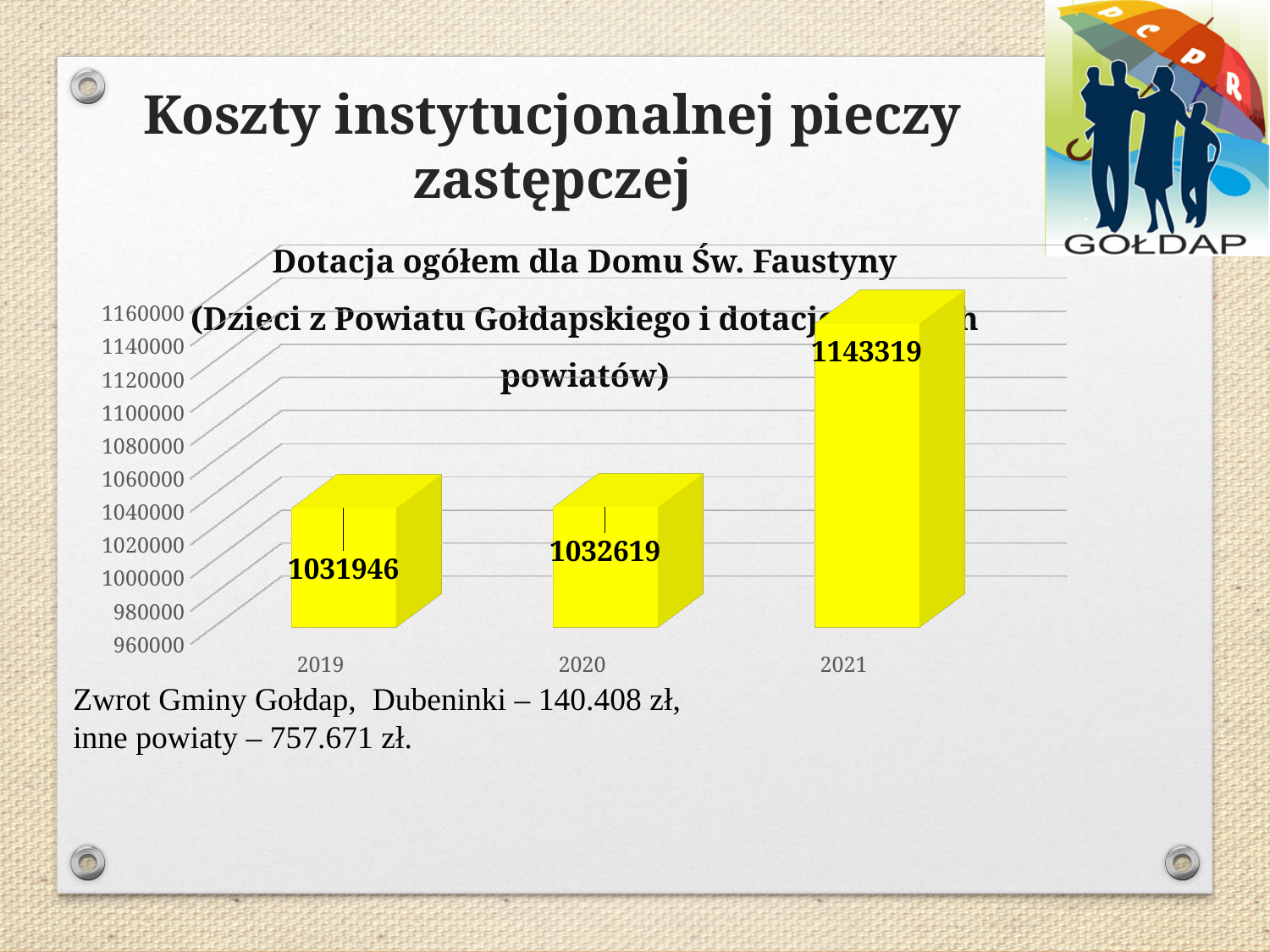
What is the value for 2021? 1143319 What kind of chart is shown on the slide? bar chart Which is larger, the value for 2021 or the value for 2019? 2021 What is the value for 2019? 1031946 Do the values rise or fall from 2019 to 2021? rise What is the difference between the values for 2020 and 2019? 673 Which year has the highest value? 2021 What is the difference between the values for 2021 and 2020? 110700 Is the value for 2021 greater or less than 1100000? greater How many years are shown on the chart? 3 What is the value for 2020? 1032619 Is the value for 2019 greater or less than 1040000? less